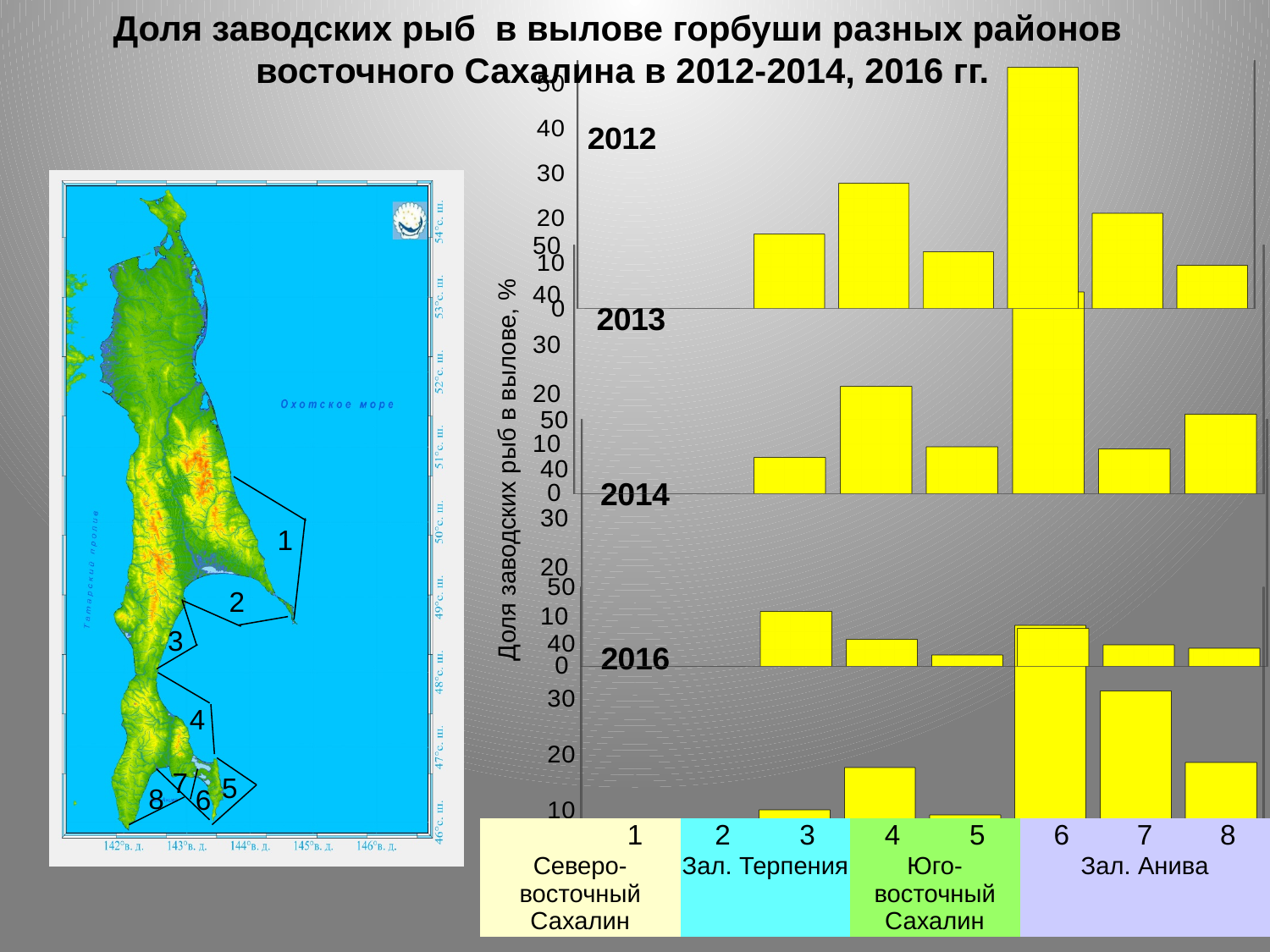
In the 2012 chart, is the value for district 3 greater or less than 20? less In the 2016 chart, is the value for district 7 greater or less than 20? greater In the 2016 chart, which district category has the highest bar? 6 In the 2012 chart, which district category has the highest bar? 6 How many separate year panels (charts) are shown on the slide? 4 In the 2013 chart, which district category has the highest bar? 6 In the 2012 chart, which is larger, the value for district 4 or the value for district 7? district 4 In the 2012 chart, is the value for district 4 greater or less than 20? greater How many district categories are shown along the x axis of the charts? 8 What is the label of the vertical axis of the charts? Доля заводских рыб в вылове, % What kind of chart is used to show the share of hatchery fish for each year on the slide? bar chart